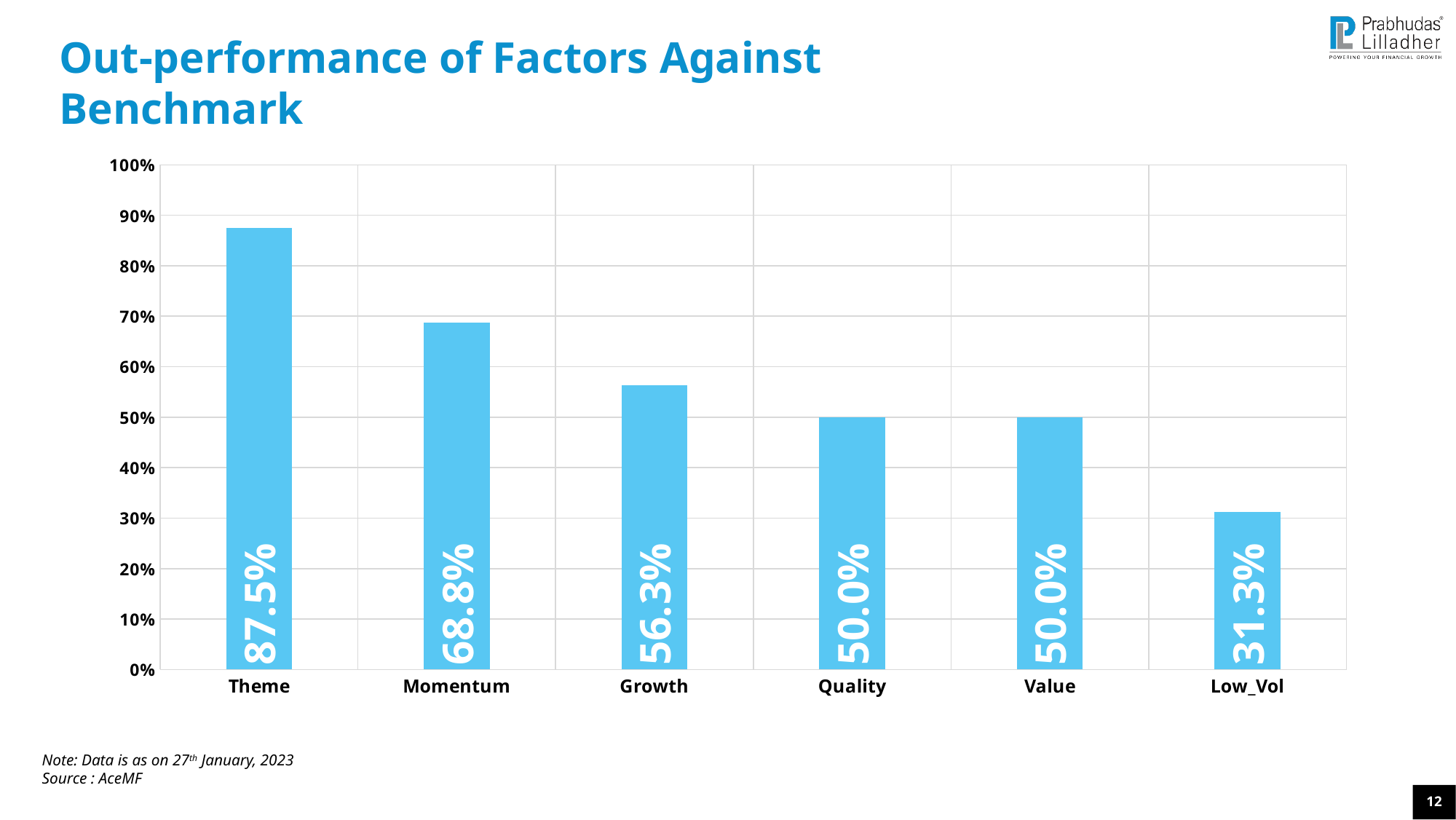
What kind of chart is shown on the slide? bar chart How many factors are shown on the x axis? 6 What is the value for Momentum? 68.8% What is the value for Theme? 87.5% Which factor has the highest value? Theme What is the value for Low_Vol? 31.3% Is the value for Growth greater or less than 60%? less What is the difference between the values for Theme and Momentum? 18.7% What is the difference between the values for Growth and Low_Vol? 25.0% Which factor has the lowest value? Low_Vol Which is larger, the value for Momentum or the value for Growth? Momentum Do the values rise or fall from Theme to Low_Vol along the x axis? fall